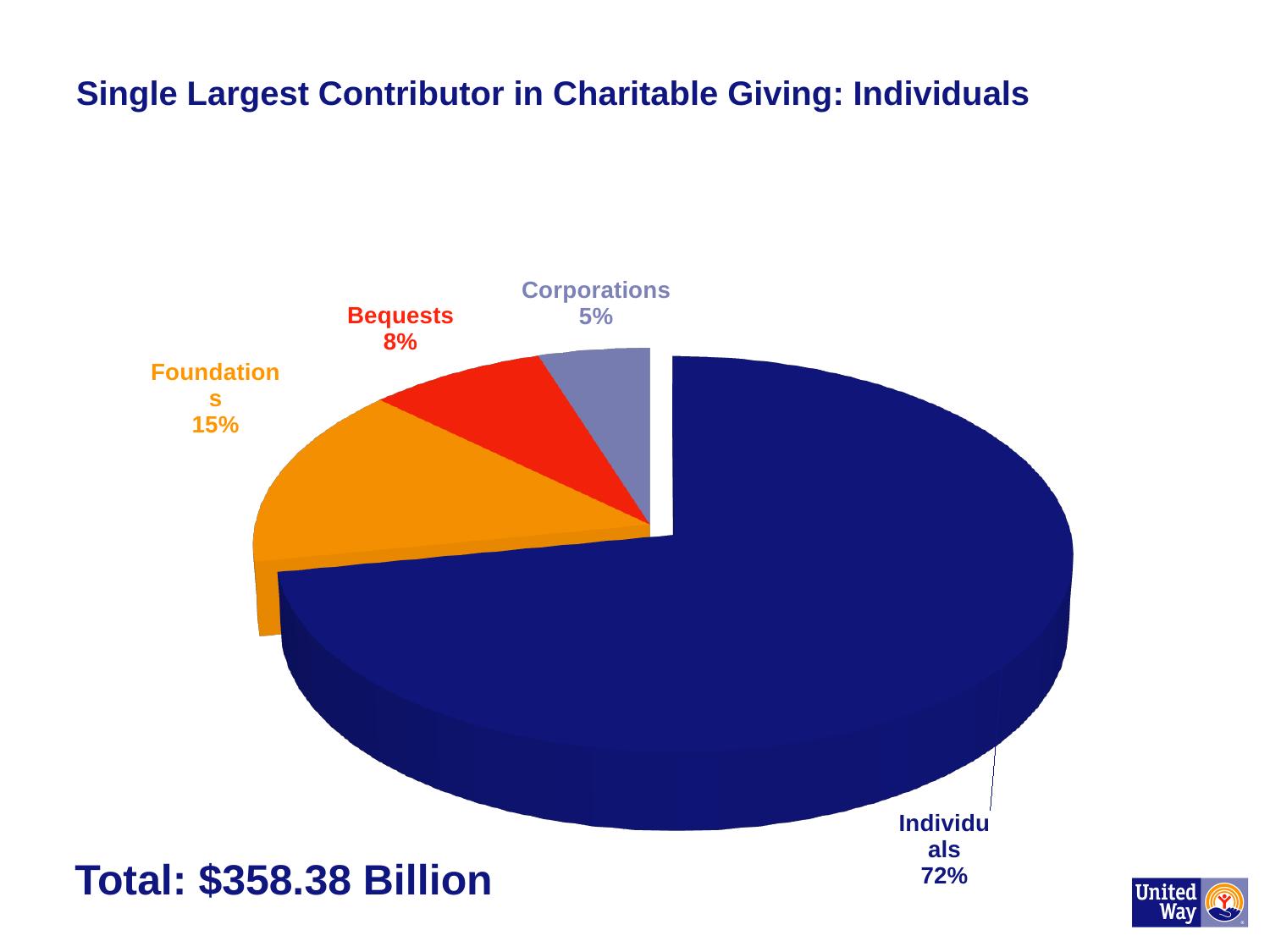
What kind of chart is shown on the slide? Pie chart Which category is the smallest contributor in the pie chart? Corporations How many percentage points larger is the Individuals share than the Foundations share? 57 What share of charitable giving comes from Individuals? 72% What share of charitable giving comes from Bequests? 8% How many categories are shown in the pie chart? 4 What share of charitable giving comes from Corporations? 5% Which category is the largest contributor in the pie chart? Individuals How many percentage points larger is the Foundations share than the Bequests share? 7 Which is larger, the share for Bequests or the share for Corporations? Bequests What total amount of charitable giving is stated on the slide? $358.38 Billion